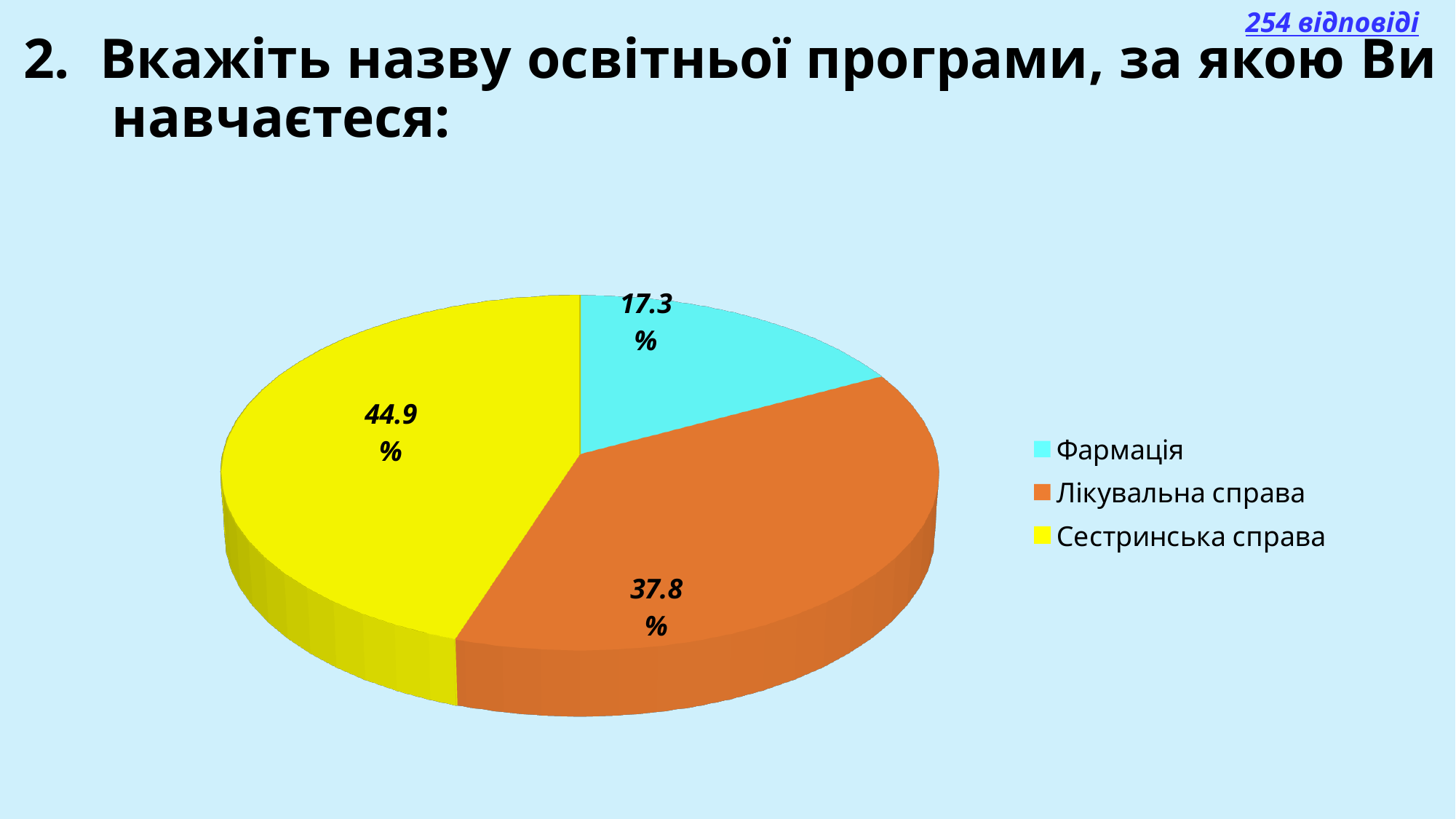
How many entries does the legend list? 3 How many slices does the pie chart have? 3 Which is larger, the share for Лікувальна справа or the share for Фармація? Лікувальна справа What share of the pie does Лікувальна справа have? 37.8% What is the difference in percentage points between Лікувальна справа and Фармація? 20.5 What is the difference in percentage points between Сестринська справа and Лікувальна справа? 7.1 What kind of chart is shown on the slide? pie chart What colour is the slice for Сестринська справа? yellow Which category has the smallest slice of the pie? Фармація What share of the pie does Фармація have? 17.3% What share of the pie does Сестринська справа have? 44.9% Which category has the largest slice of the pie? Сестринська справа